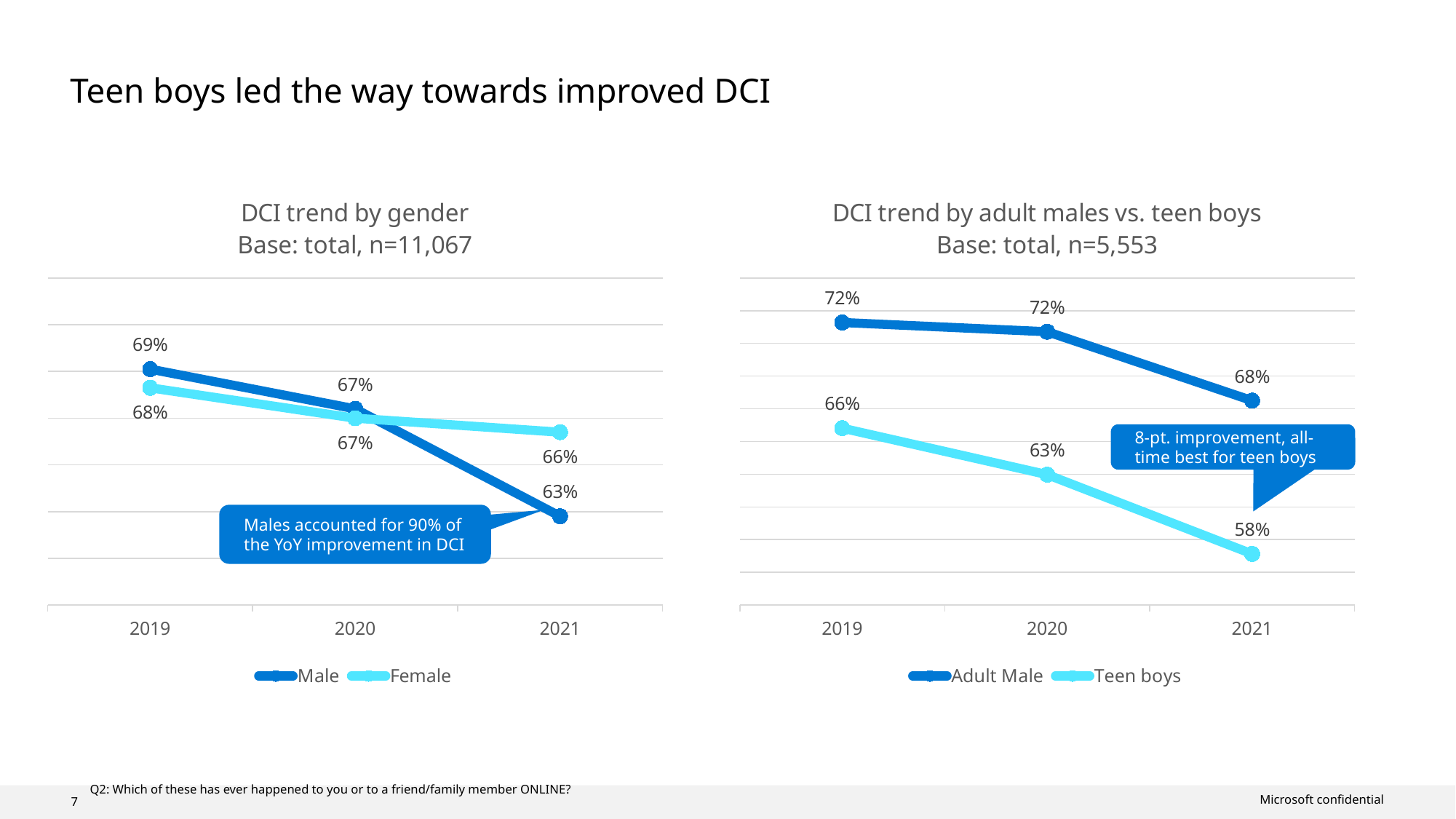
How many series does the legend of the 'DCI trend by gender' chart list? 2 In the 'DCI trend by adult males vs. teen boys' chart, what is the difference between Adult Male and Teen boys in 2021? 10 percentage points In the 'DCI trend by adult males vs. teen boys' chart, what is the value for Teen boys in 2021? 58% How many years are plotted on the x axis of the 'DCI trend by gender' chart? 3 In the 'DCI trend by gender' chart, what is the value for Female in 2019? 68% What type of chart is the 'DCI trend by adult males vs. teen boys' chart? Line chart In the 'DCI trend by gender' chart, which series has the higher value in 2021, Male or Female? Female In the 'DCI trend by adult males vs. teen boys' chart, in which year is the Teen boys value lowest? 2021 In the 'DCI trend by gender' chart, what is the value for Male in 2021? 63% In the 'DCI trend by adult males vs. teen boys' chart, what is the value for Adult Male in 2020? 72% In the 'DCI trend by gender' chart, what is the difference between the Female and Male values in 2021? 3 percentage points In the 'DCI trend by adult males vs. teen boys' chart, do the Teen boys values rise or fall from 2019 to 2021? Fall